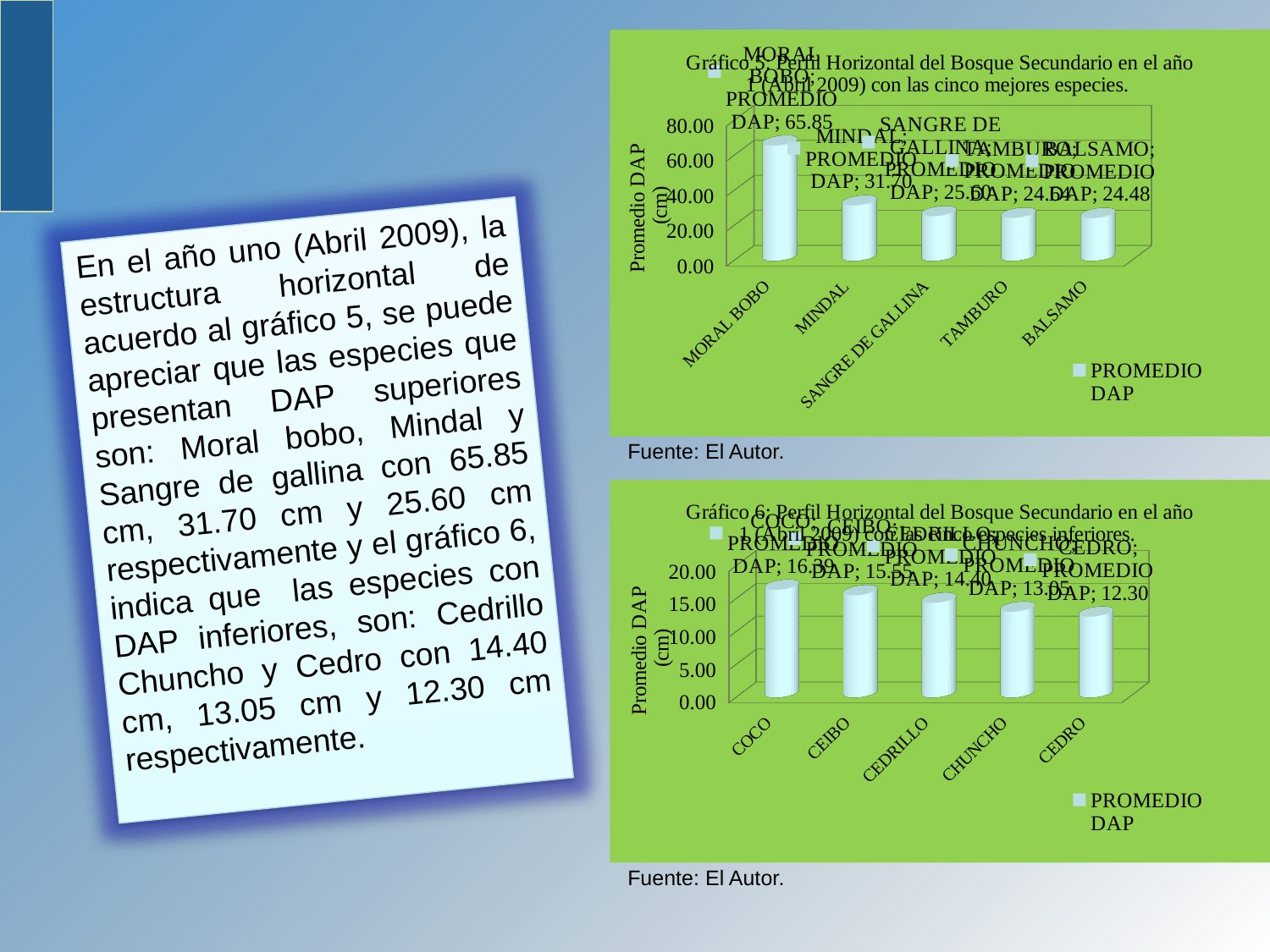
In Gráfico 5, how many species are shown on the x axis? 5 In Gráfico 6, which is larger, the Promedio DAP of COCO or CHUNCHO? COCO In Gráfico 5, what is the Promedio DAP value for MORAL BOBO? 65.85 What kind of chart is Gráfico 6? bar chart In Gráfico 5, what is the Promedio DAP value for MINDAL? 31.70 In Gráfico 5, which species has the highest Promedio DAP? MORAL BOBO In Gráfico 5, is the value for SANGRE DE GALLINA greater or less than 40.00? less In Gráfico 6, which species has the lowest Promedio DAP? CEDRO In Gráfico 6, do the values rise or fall from COCO to CEDRO along the x axis? fall In Gráfico 5, what is the difference between the Promedio DAP of MORAL BOBO and MINDAL? 34.15 In Gráfico 6, what is the Promedio DAP value for CEDRO? 12.30 In Gráfico 6, what is the Promedio DAP value for CEDRILLO? 14.40